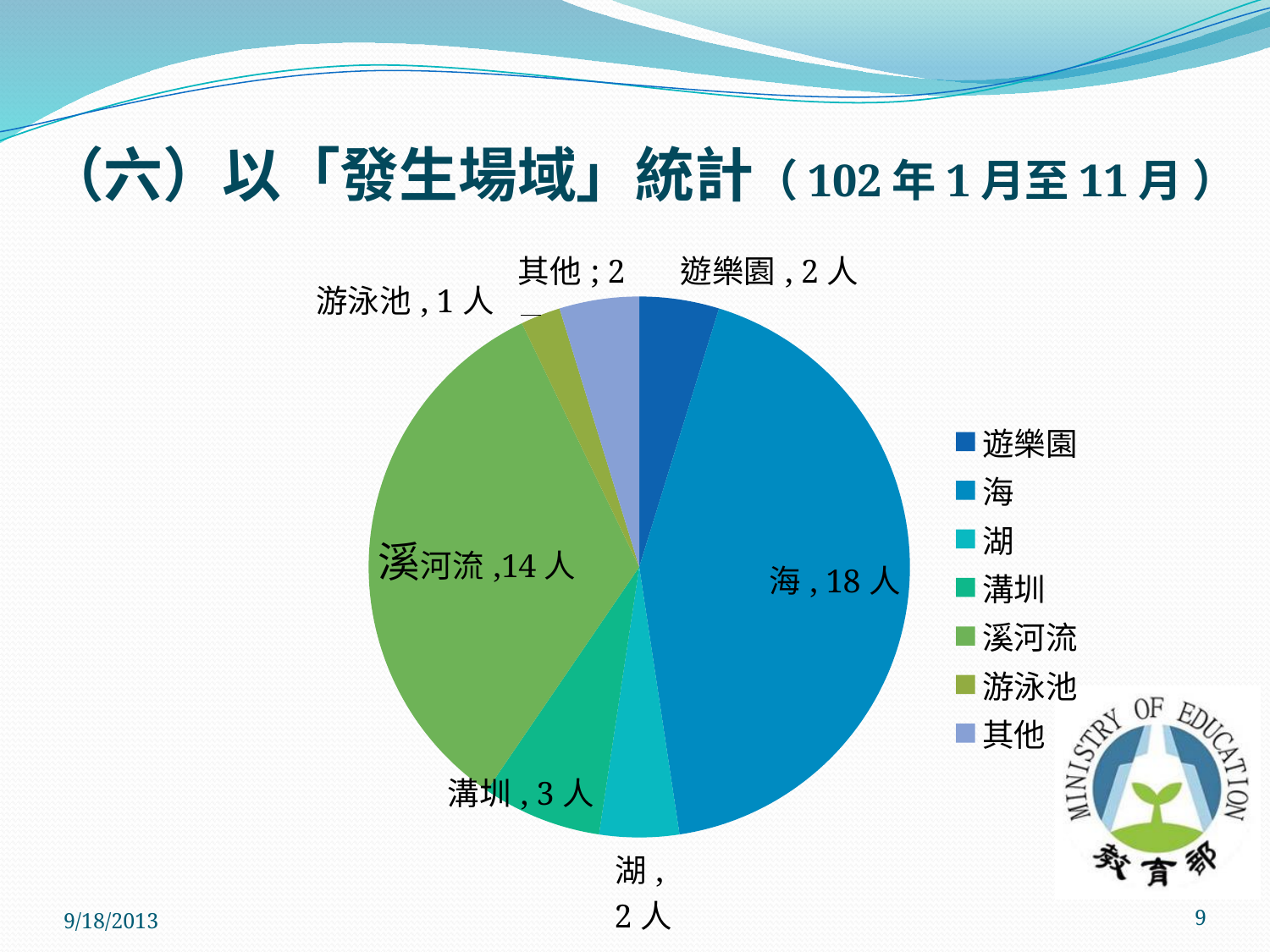
How many people does the 海 slice represent? 18 人 What kind of chart is shown on the slide? pie chart Which category has the largest slice of the pie? 海 What is the difference between the values for 海 and 溪河流? 4 人 What is the value shown for 溪河流? 14 人 What is the value shown for 溝圳? 3 人 Which is larger, the value for 溝圳 or the value for 湖? 溝圳 How many categories does the pie chart have? 7 Which category has the smallest slice of the pie? 游泳池 What is the value shown for 游泳池? 1 人 What colour is the 溪河流 slice in the pie chart? green What is the total of all the slices in the pie chart? 42 人